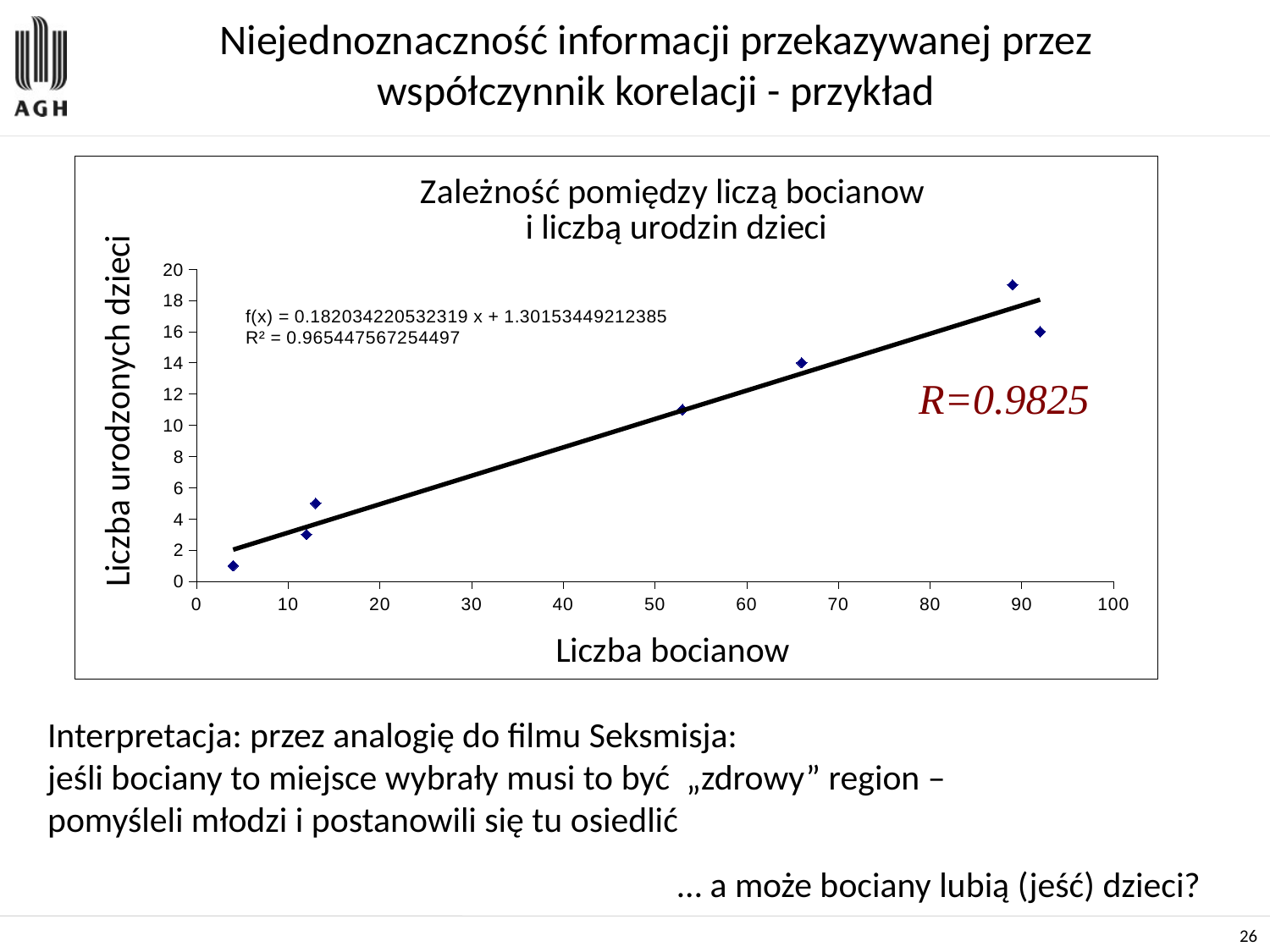
Which has the higher Liczba urodzonych dzieci: the point at about 89 bocianow or the point at about 92 bocianow? the point at about 89 bocianow Do the values of Liczba urodzonych dzieci rise or fall as Liczba bocianow increases along the x axis? rise Is the value of Liczba urodzonych dzieci for the point at about 66 bocianow greater or less than 12? greater What kind of chart is shown on the slide? scatter chart What value of R is printed on the chart? R=0.9825 What is the highest value shown on the y axis of the chart? 20 Is the value of Liczba urodzonych dzieci for the leftmost point (about 4 bocianow) greater or less than 2? less Is the value of Liczba urodzonych dzieci for the point at about 92 bocianow greater or less than 14? greater Which has the lower Liczba urodzonych dzieci: the point at about 12 bocianow or the point at about 53 bocianow? the point at about 12 bocianow How many data points are plotted on the chart? 7